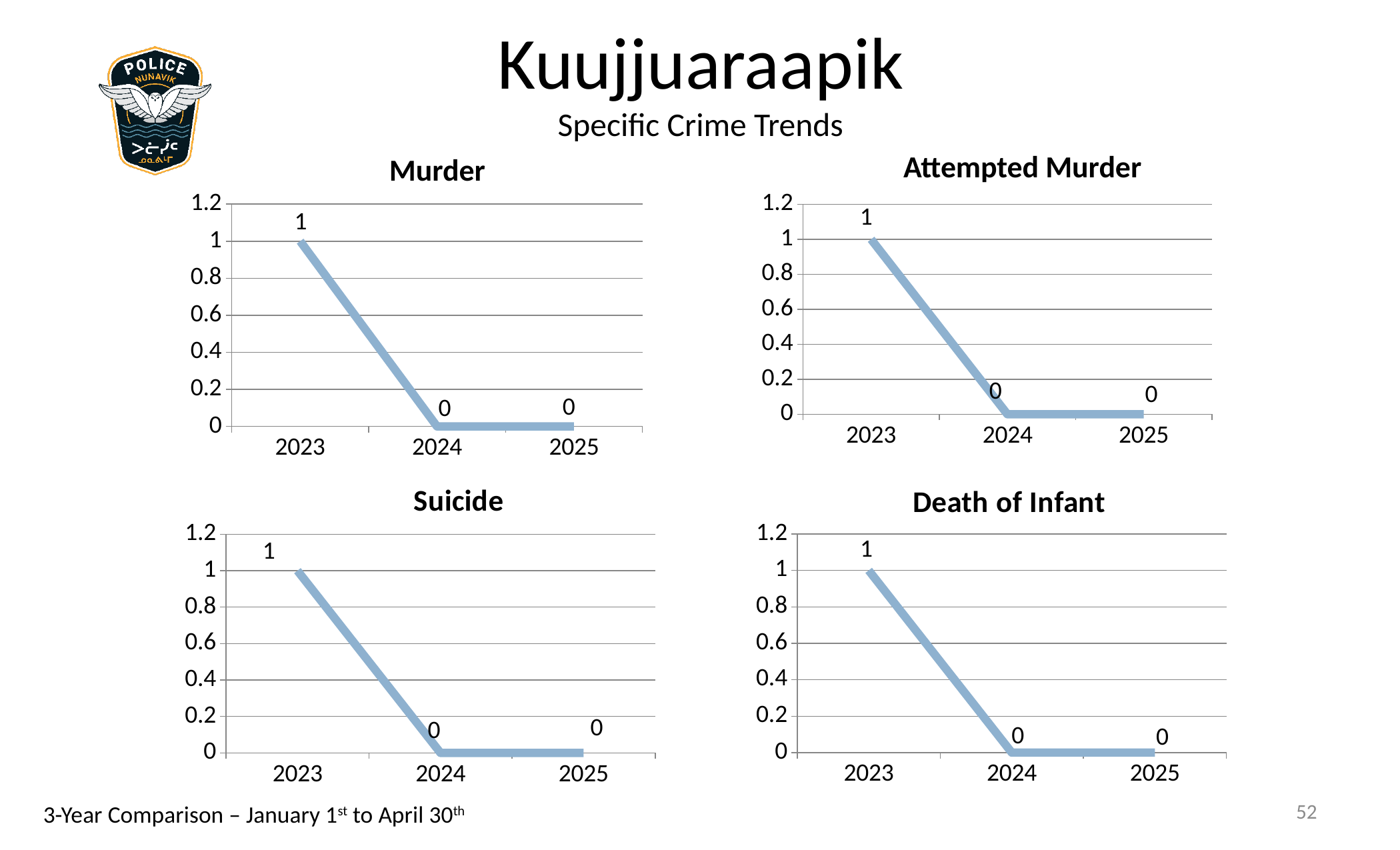
In the Attempted Murder chart, what is the value for 2024? 0 In the Murder chart, what is the value for 2023? 1 In the Suicide chart, what is the difference between the 2023 value and the 2024 value? 1 In the Murder chart, which year has the highest value? 2023 What is the title of the chart in the bottom right of the slide? Death of Infant In the Murder chart, do the values rise or fall from 2023 to 2024? fall In the Suicide chart, what is the value for 2025? 0 In the Death of Infant chart, which is larger, the value for 2023 or the value for 2025? 2023 What kind of chart is the Suicide chart? line chart How many charts are shown on the slide? 4 How many years are plotted on the x axis of the Attempted Murder chart? 3 In the Death of Infant chart, what is the value for 2023? 1